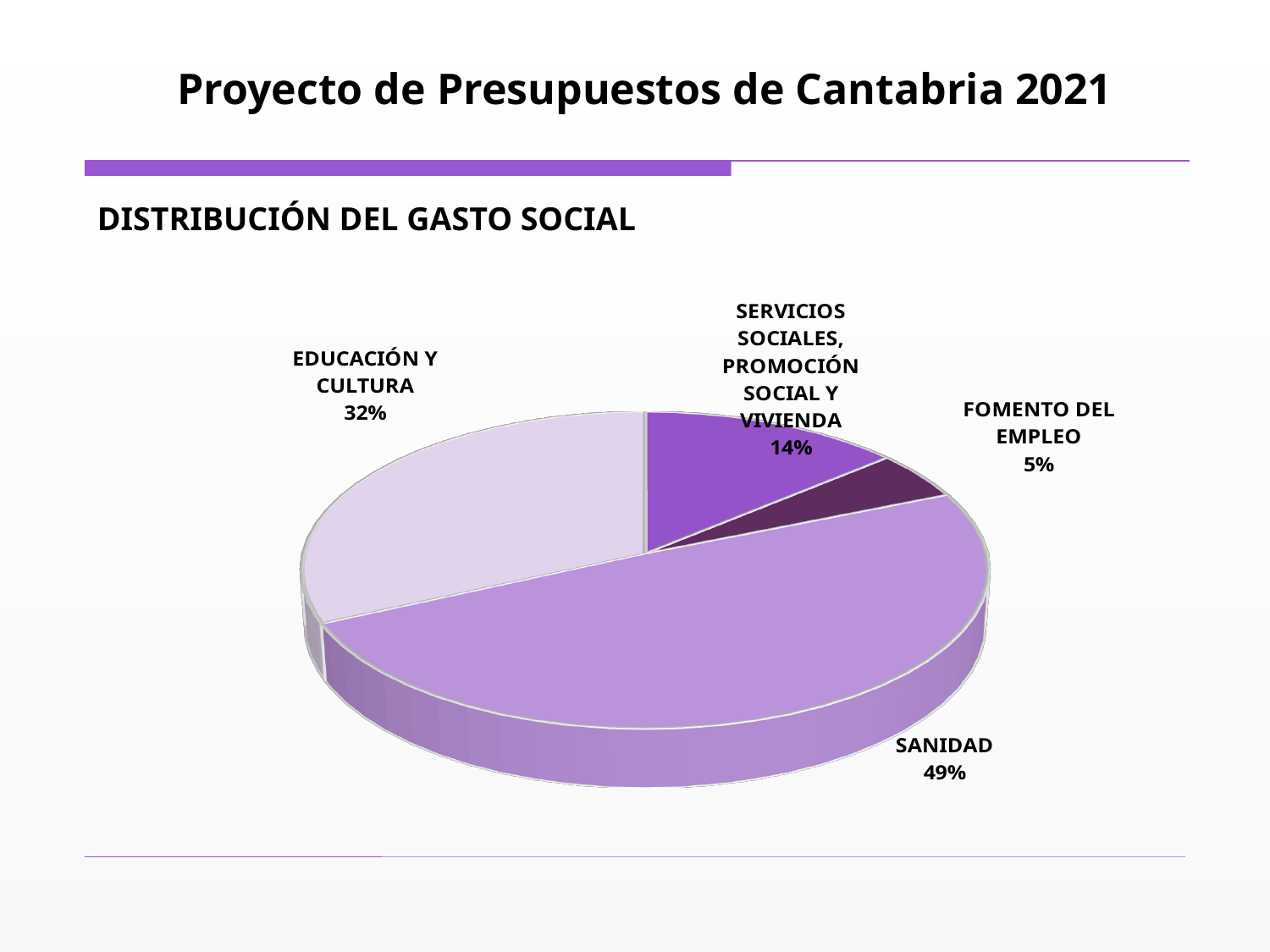
Which is larger, the share for EDUCACIÓN Y CULTURA or the share for SERVICIOS SOCIALES, PROMOCIÓN SOCIAL Y VIVIENDA? EDUCACIÓN Y CULTURA Which category has the largest share of the pie? SANIDAD What percentage is shown for SERVICIOS SOCIALES, PROMOCIÓN SOCIAL Y VIVIENDA? 14% What percentage is shown for FOMENTO DEL EMPLEO? 5% What is the difference in percentage points between SANIDAD and EDUCACIÓN Y CULTURA? 17 What share of social spending goes to SANIDAD? 49% What is the title of the chart? DISTRIBUCIÓN DEL GASTO SOCIAL What is the combined share of SERVICIOS SOCIALES, PROMOCIÓN SOCIAL Y VIVIENDA and FOMENTO DEL EMPLEO? 19% How many categories are shown in the pie chart? 4 Which category has the smallest share of the pie? FOMENTO DEL EMPLEO What kind of chart is shown on the slide? Pie chart What percentage is shown for EDUCACIÓN Y CULTURA? 32%